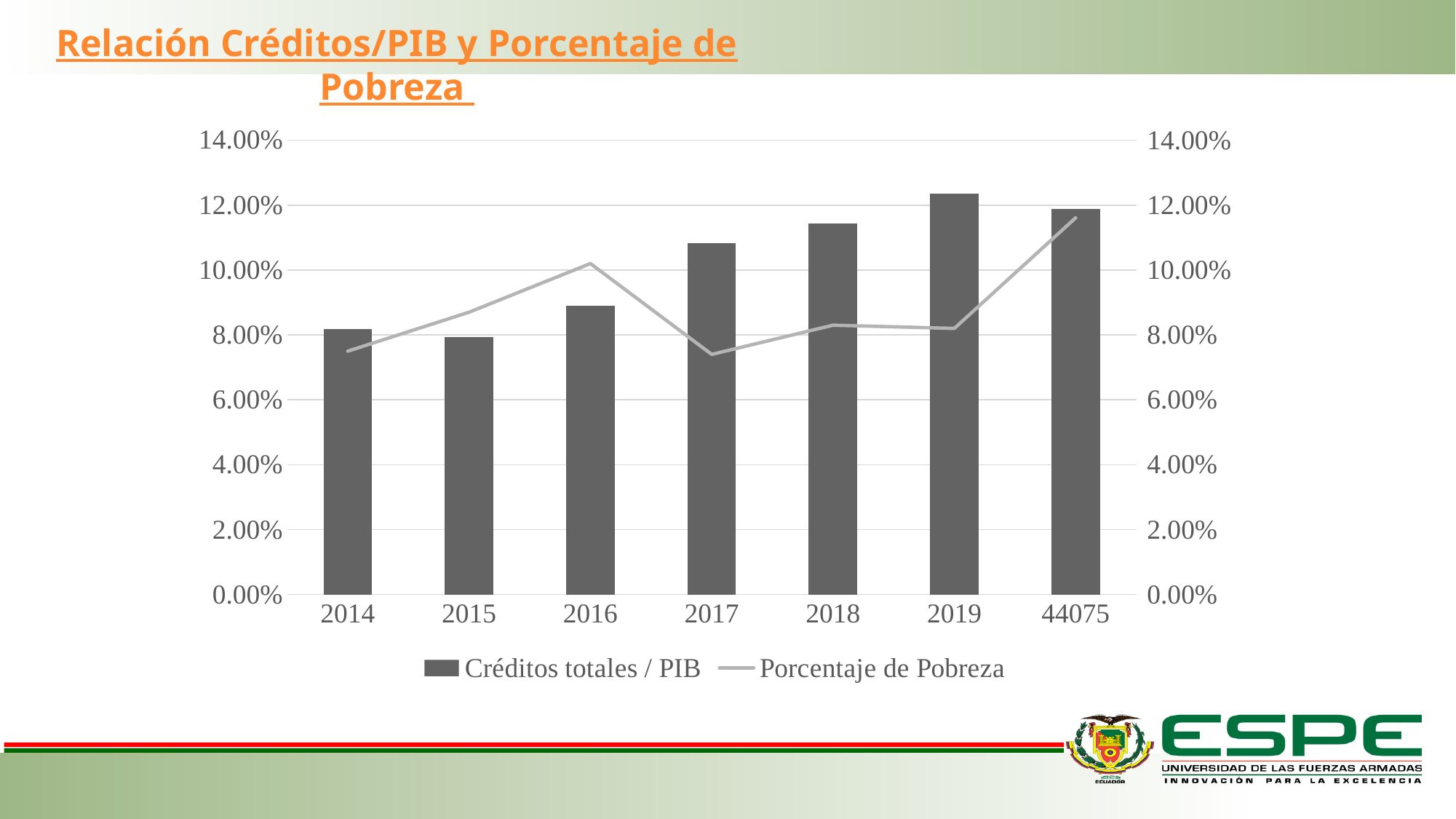
Which year has the lowest bar for Créditos totales / PIB? 2015 Is the Porcentaje de Pobreza value for 2016 greater or less than 10.00%? greater What kind of chart is shown on the slide? A combined bar and line chart How many categories are shown on the x axis? 7 Is the Porcentaje de Pobreza value for 2017 greater or less than 8.00%? less Which year has the highest bar for Créditos totales / PIB? 2019 At which x-axis category does the Porcentaje de Pobreza line reach its highest point? 44075 Do the Créditos totales / PIB bars generally rise or fall from 2014 to 2019? rise Is the Créditos totales / PIB value for 2017 greater or less than 10.00%? greater Which is larger, the Créditos totales / PIB bar for 2018 or for 2016? 2018 How many series does the legend list? 2